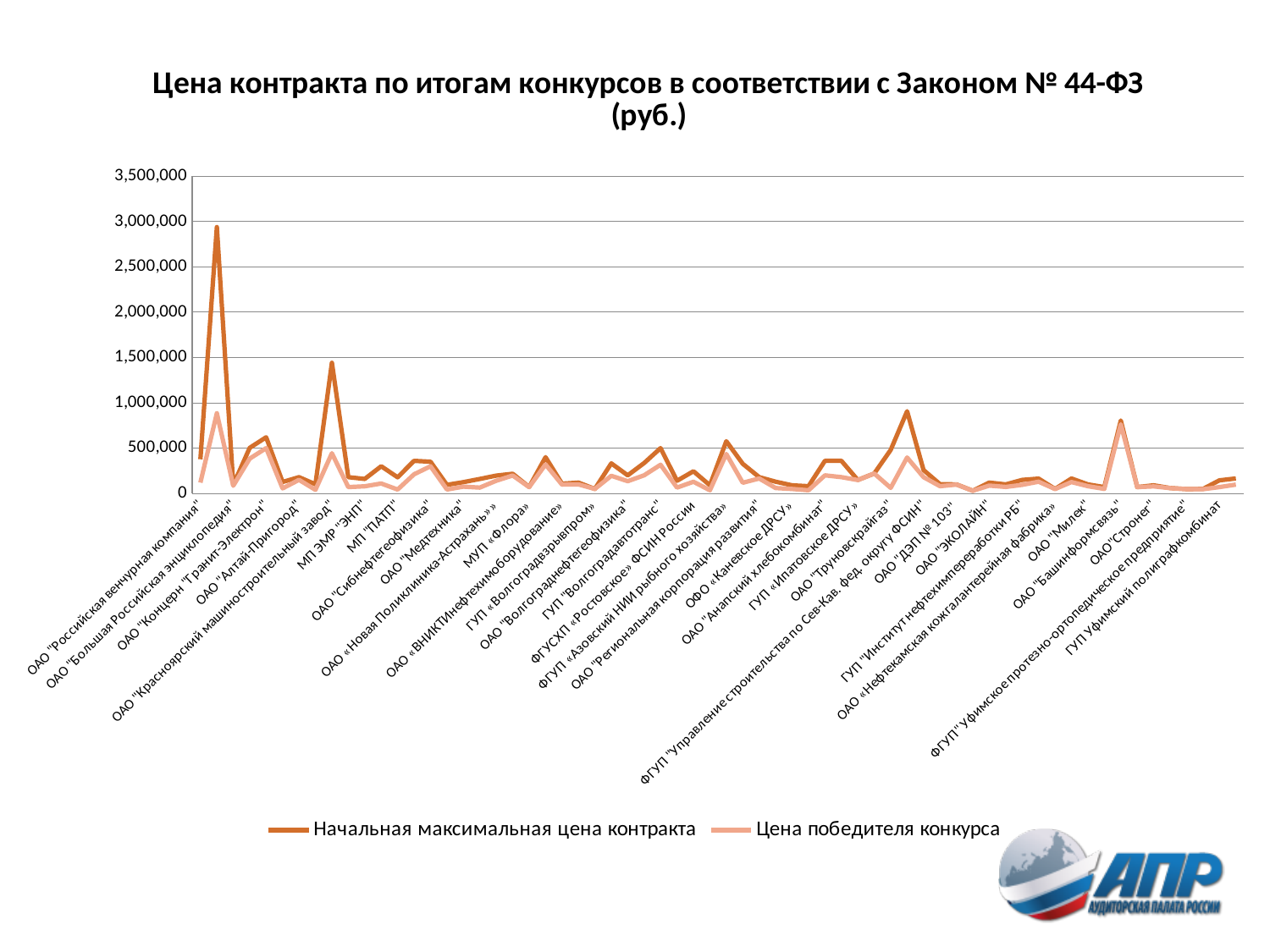
What are the two series named in the legend? Начальная максимальная цена контракта; Цена победителя конкурса What is the title of the chart? Цена контракта по итогам конкурсов в соответствии с Законом № 44-ФЗ (руб.) Is the highest value of the Цена победителя конкурса series greater or less than 1,000,000? less What kind of chart is shown on the slide? line chart Is the Начальная максимальная цена контракта value for ОАО "Красноярский машиностроительный завод" greater or less than 1,000,000? greater Is the highest value of the Начальная максимальная цена контракта series greater or less than 2,500,000? greater How many series does the legend list? 2 Which series reaches the higher peak, Начальная максимальная цена контракта or Цена победителя конкурса? Начальная максимальная цена контракта